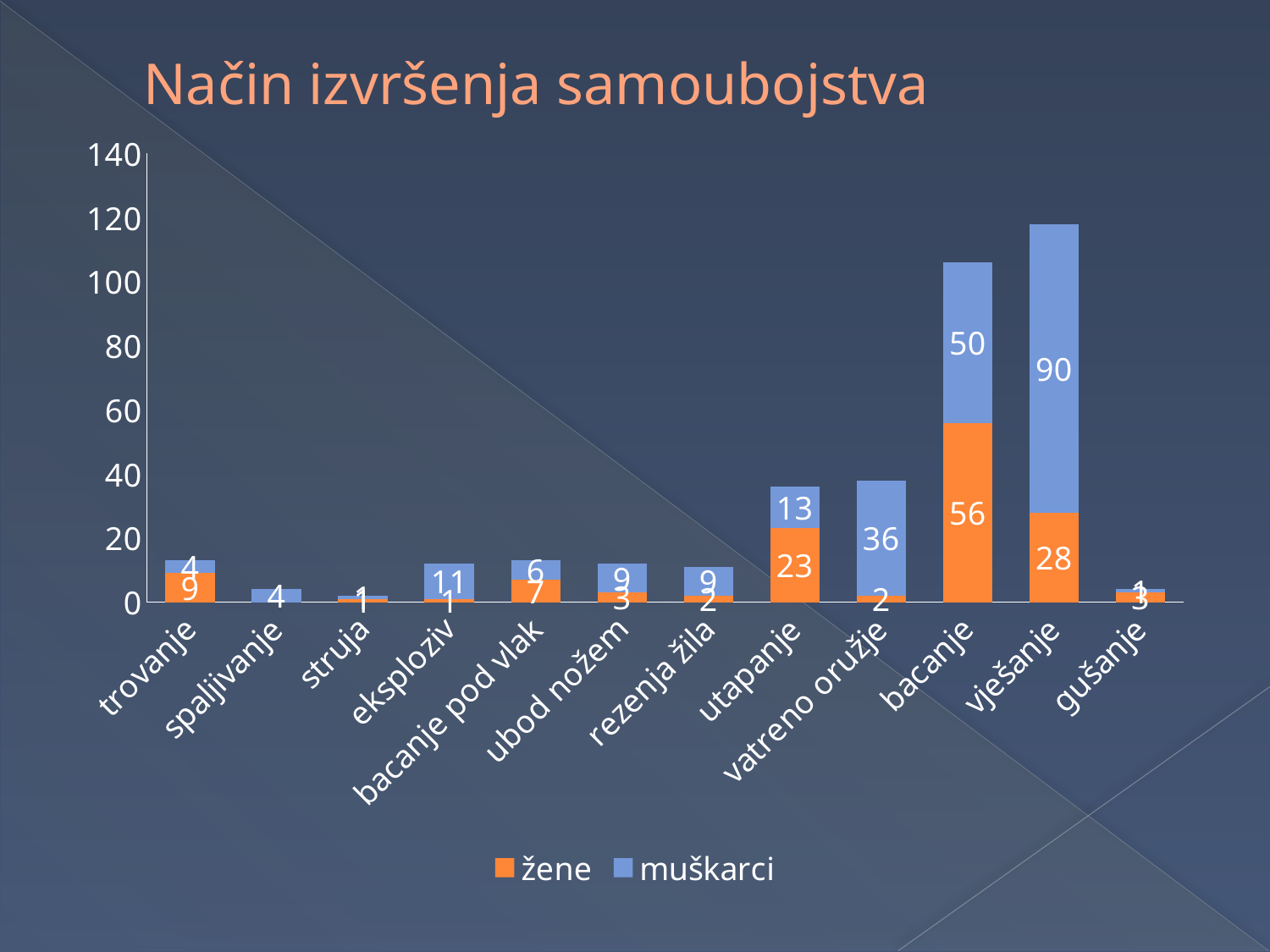
What is the total of the stacked bar for vješanje? 118 Which is larger in the utapanje category, the žene value or the muškarci value? žene What type of chart is shown on the slide? stacked bar chart What is the value for muškarci in the vatreno oružje category? 36 What is the value for žene in the bacanje category? 56 Is the total stacked value for vješanje greater or less than 100? greater What is the value for muškarci in the vješanje category? 90 How many categories are shown on the x axis? 12 What is the difference between the žene and muškarci values in the bacanje category? 6 How many series does the legend list? 2 What is the value for žene in the utapanje category? 23 Which category has the tallest stacked bar overall? vješanje